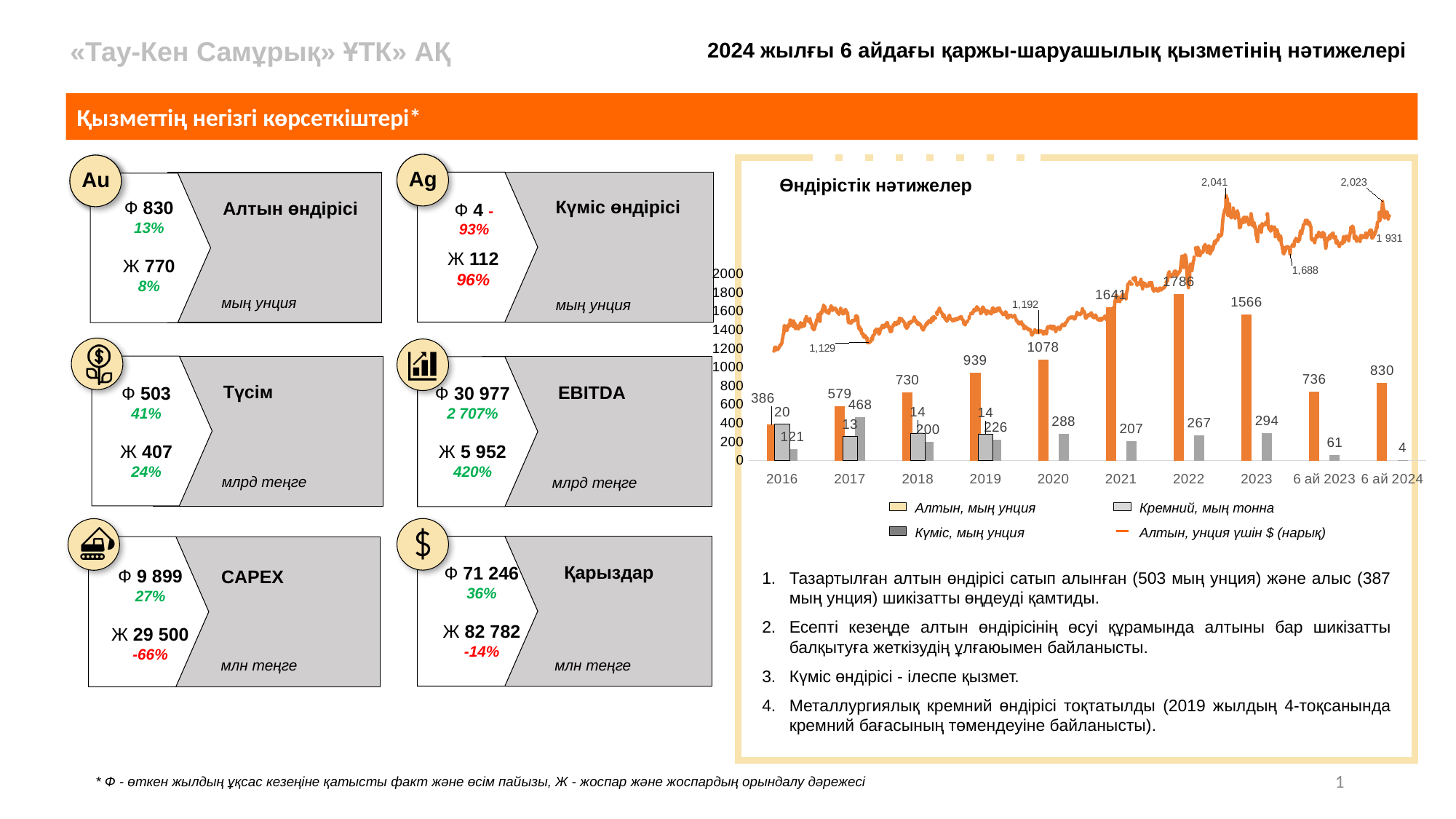
Which year has the highest value for Алтын, мың унция? 2022 Which is larger, the Алтын, мың унция value for 2021 or for 2023? 2021 How many series does the chart legend list? 4 What is the value of Алтын, мың унция for 2022? 1786 What is the value of Кремний, мың тонна for 2016? 20 What is the value of Күміс, мың унция for 2017? 468 What is the value of Алтын, мың унция for 2020? 1078 Which category has the lowest value for Күміс, мың унция? 6 ай 2024 Does the value of Алтын, мың унция rise or fall from 2016 to 2022? rise What is the difference between the Алтын, мың унция values for 6 ай 2024 and 6 ай 2023? 94 How many categories are shown on the x axis of the chart? 10 What is the title of the chart on the slide? Өндірістік нәтижелер